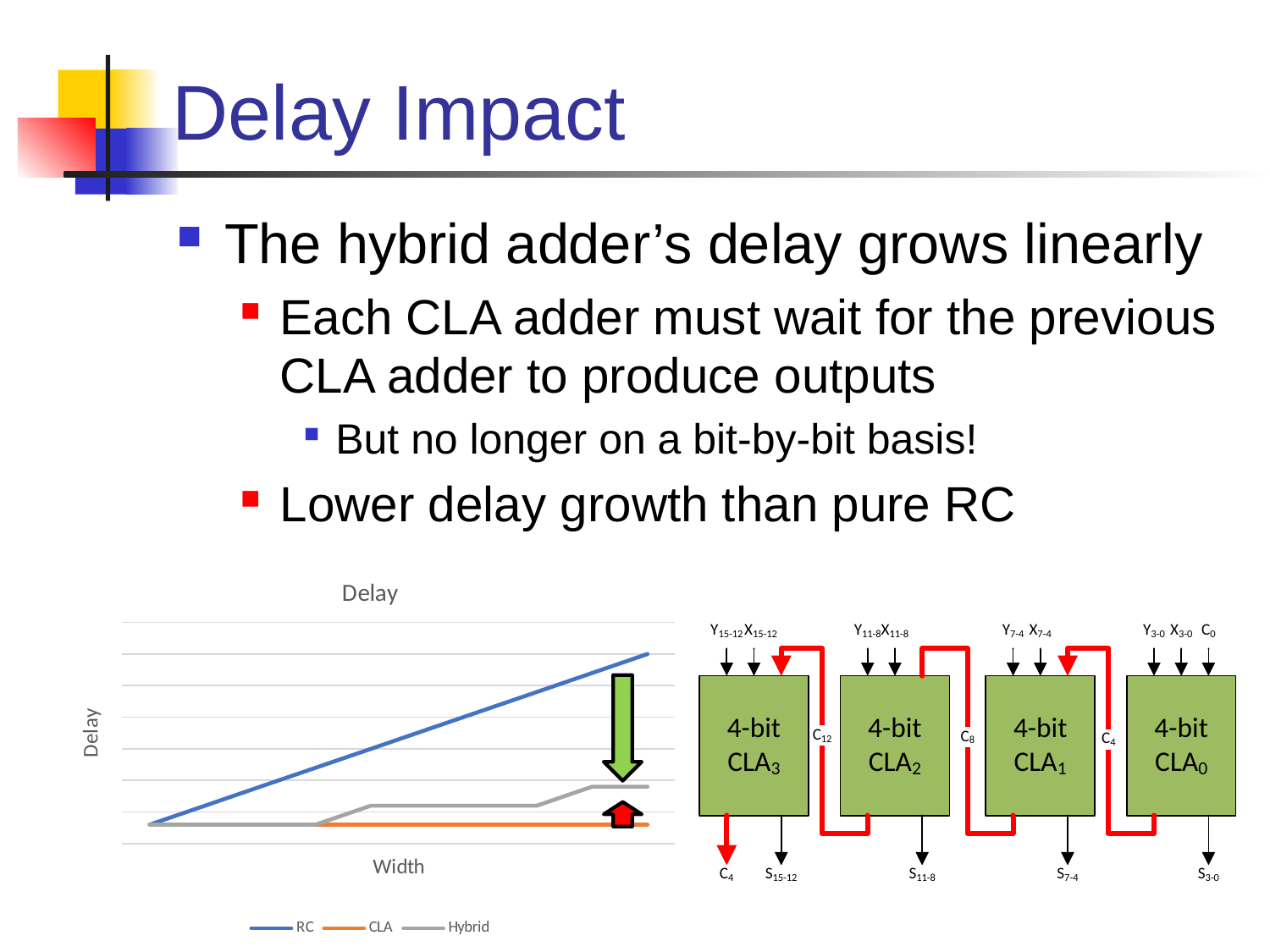
What kind of chart is shown on the slide? line chart At the right end of the chart, which series has the larger delay, Hybrid or CLA? Hybrid What is the title of the chart? Delay At the right end of the chart, which series has the larger delay, RC or Hybrid? RC Does the CLA series rise, fall, or stay flat as width increases? stay flat Does the RC series rise or fall as width increases? rise How many series does the chart's legend list? 3 Which series has the lowest delay at the right end of the chart? CLA What are the names of the series listed in the chart's legend? RC, CLA, Hybrid What is the label of the chart's x axis? Width Which series reaches the highest delay at the right end of the chart? RC